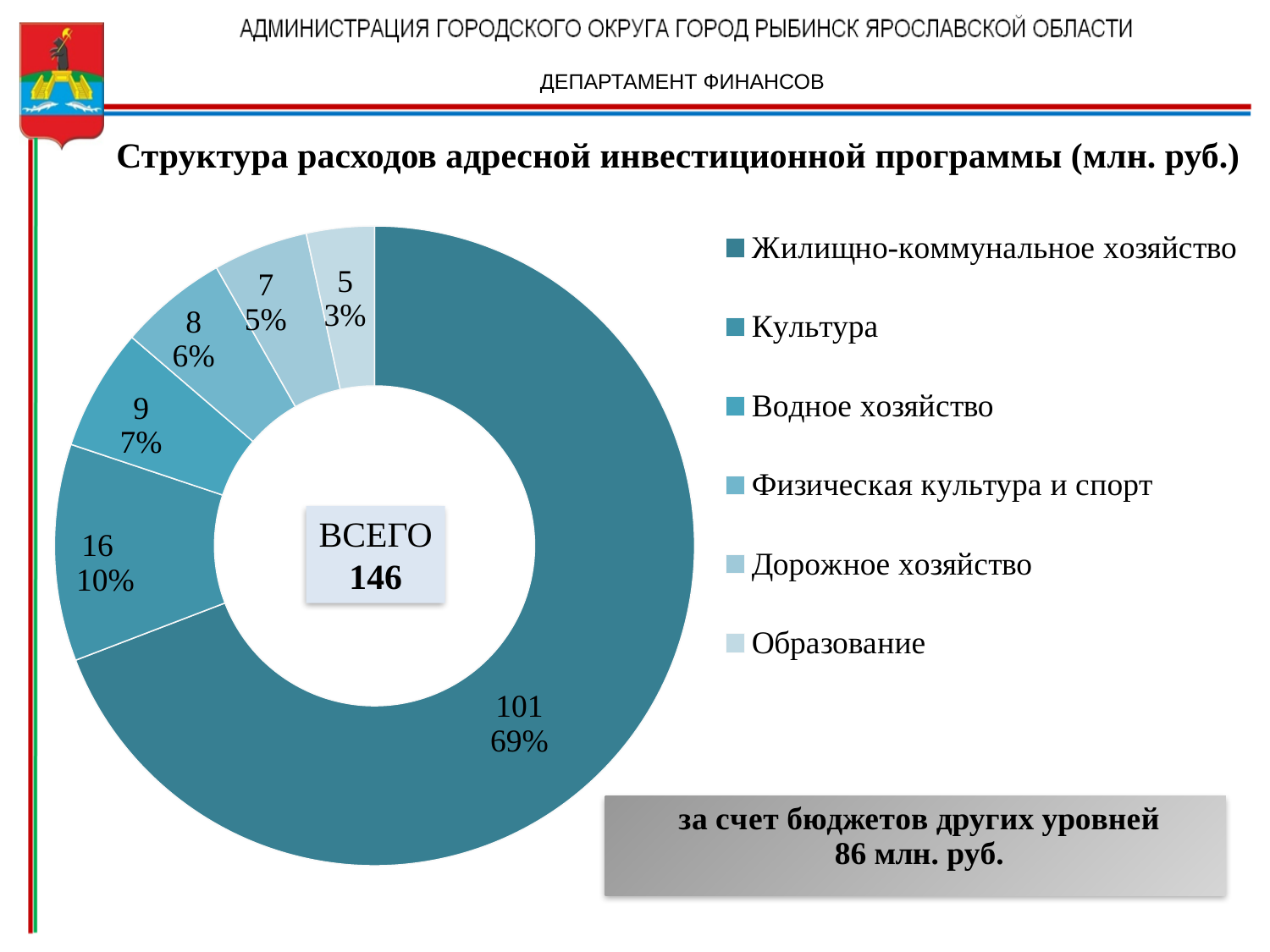
How many categories does the chart show? 6 What is the value for Образование? 5 What share of the total does Дорожное хозяйство account for? 5% Which category has the largest value? Жилищно-коммунальное хозяйство What share of the total does Водное хозяйство account for? 7% What is the value for Культура? 16 What is the difference between the values for Культура and Физическая культура и спорт? 8 What total (ВСЕГО) is shown in the centre of the chart? 146 Which category has the smallest value? Образование What type of chart is shown on the slide? doughnut (pie) chart What is the value for Жилищно-коммунальное хозяйство? 101 Which is larger, the value for Водное хозяйство or the value for Дорожное хозяйство? Водное хозяйство